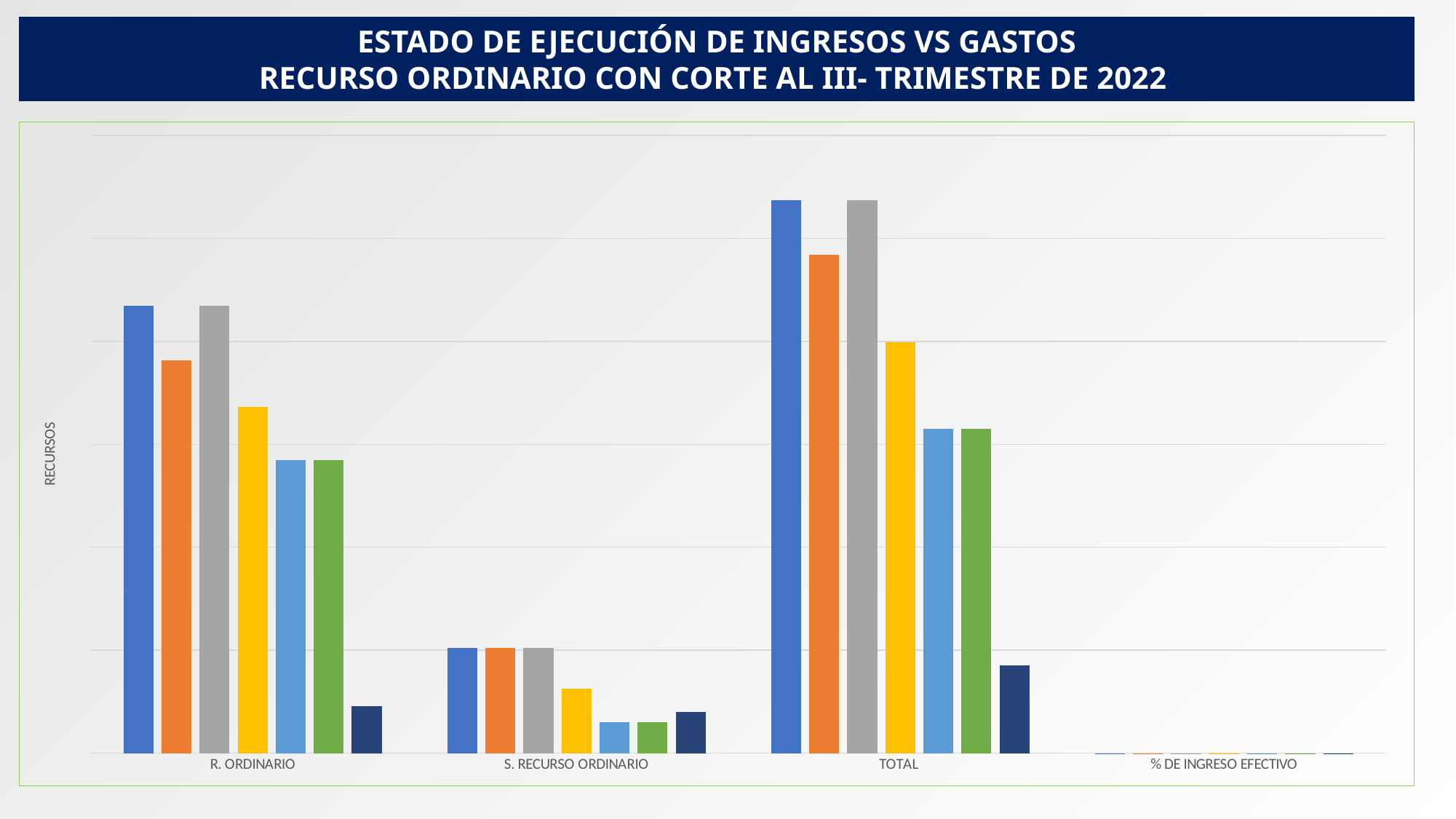
What is the title shown above the chart? ESTADO DE EJECUCIÓN DE INGRESOS VS GASTOS RECURSO ORDINARIO CON CORTE AL III- TRIMESTRE DE 2022 Within the R. ORDINARIO category, which bar is the shortest? The dark navy (last) bar Which category has the tallest bars in the chart? TOTAL What is the label on the vertical axis of the chart? RECURSOS Is the blue (first) bar taller for R. ORDINARIO or for S. RECURSO ORDINARIO? R. ORDINARIO Is the yellow bar taller for TOTAL or for R. ORDINARIO? TOTAL What kind of chart is shown on the slide? Bar chart Which category has the lowest bars in the chart? % DE INGRESO EFECTIVO How many bars are plotted for the R. ORDINARIO category? 7 How many categories are shown along the x axis of the chart? 4 Within the S. RECURSO ORDINARIO category, is the orange bar taller or shorter than the yellow bar? Taller